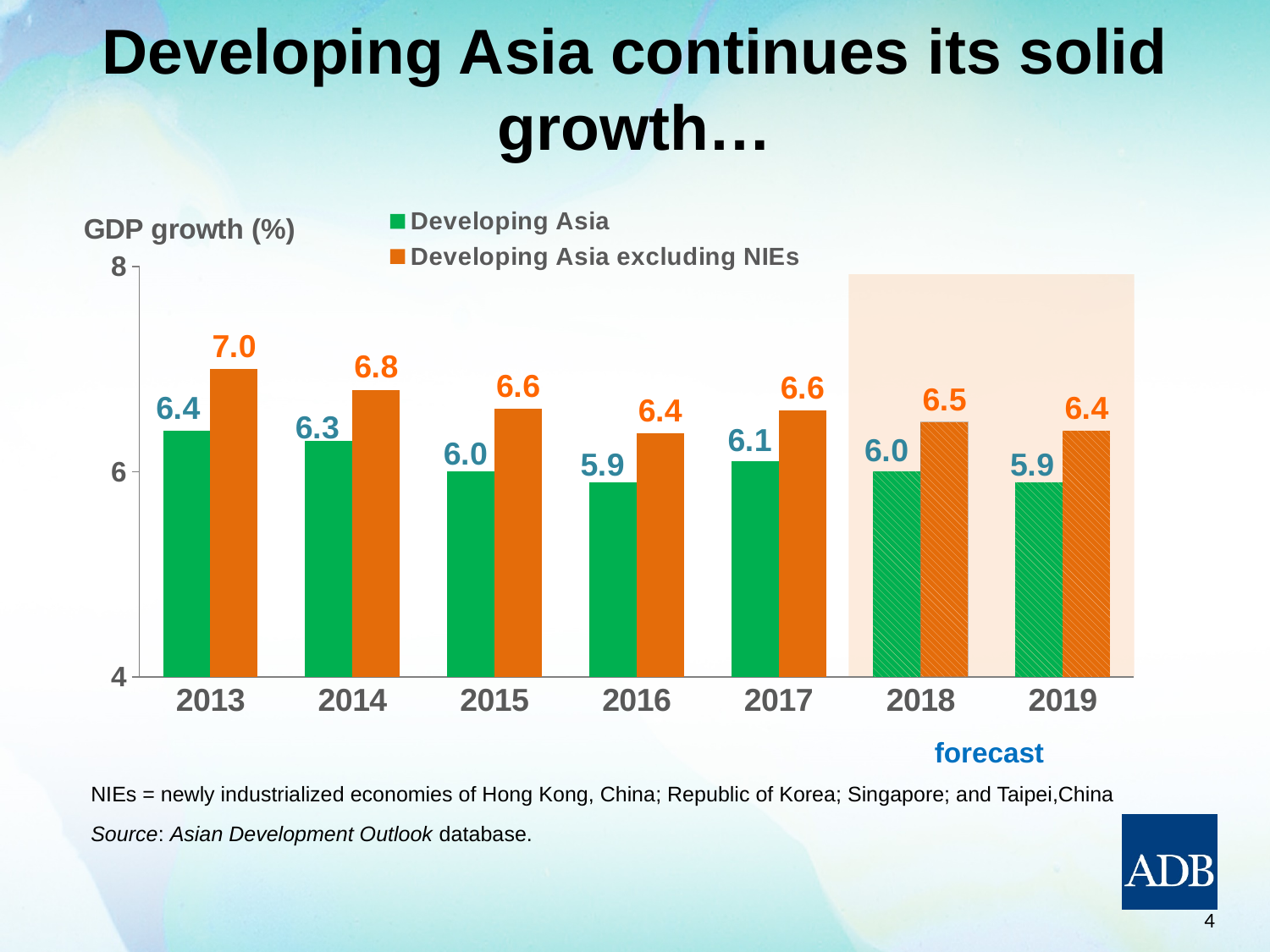
Is the Developing Asia value for 2015 greater or less than 8? less Which years are marked as forecast on the chart? 2018 and 2019 What is the difference between the Developing Asia excluding NIEs value and the Developing Asia value in 2014? 0.5 Which is larger in 2017: the Developing Asia value or the Developing Asia excluding NIEs value? Developing Asia excluding NIEs How many years are shown on the x axis? 7 What is the GDP growth value for Developing Asia in 2013? 6.4 What is the GDP growth value for Developing Asia in 2016? 5.9 What is the lowest value shown for the Developing Asia series? 5.9 How many series does the legend list? 2 What is the GDP growth value for Developing Asia excluding NIEs in 2018? 6.5 In which year is the Developing Asia excluding NIEs value highest? 2013 What kind of chart is shown on the slide? bar chart